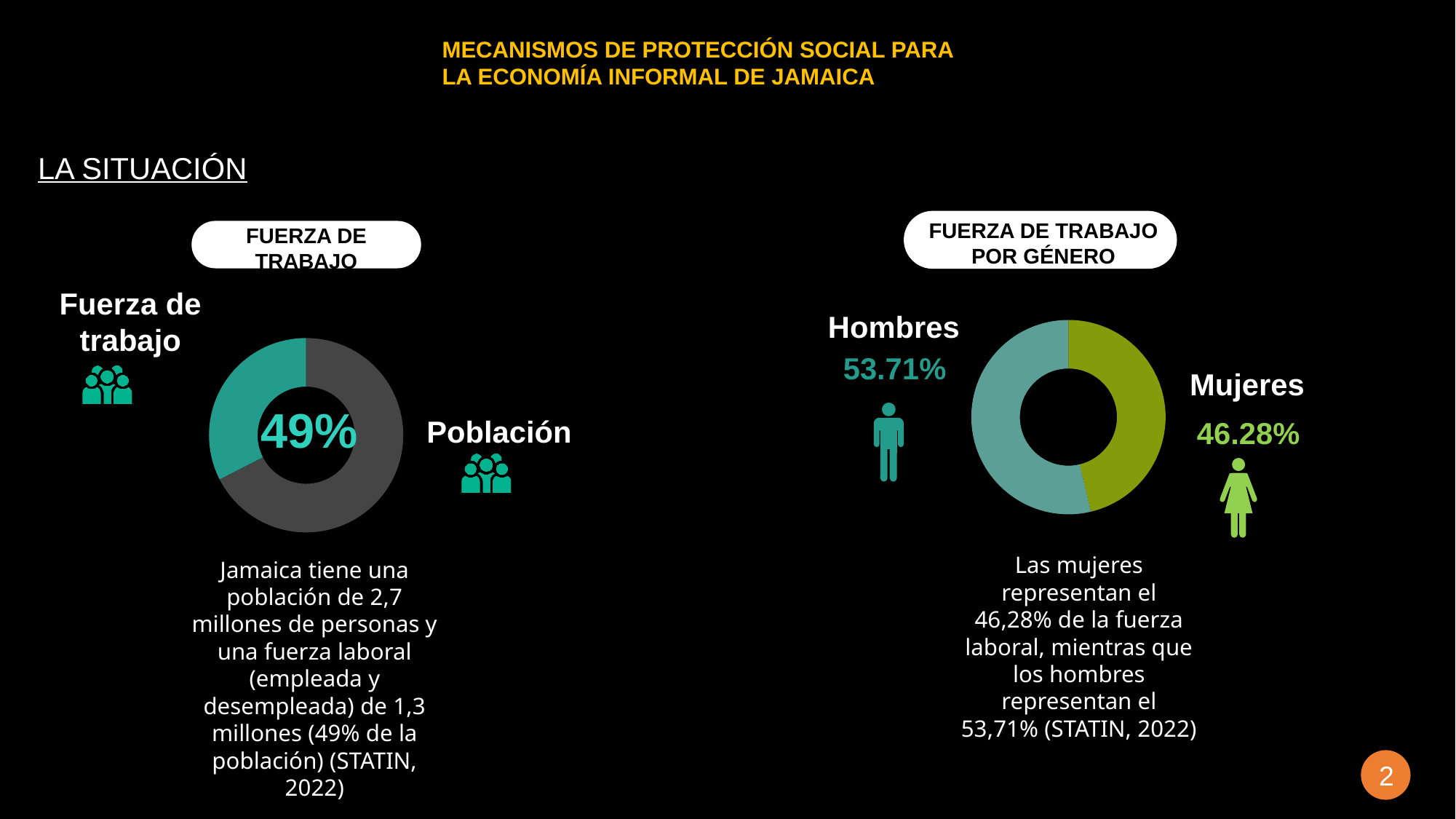
In the 'FUERZA DE TRABAJO' chart on the left, what are the two labelled categories? Fuerza de trabajo and Población In the 'FUERZA DE TRABAJO POR GÉNERO' chart, what percentage is shown for Hombres? 53.71% In the 'FUERZA DE TRABAJO POR GÉNERO' chart, which category has the smallest share? Mujeres How many categories are shown in the 'FUERZA DE TRABAJO' chart on the left? 2 In the 'FUERZA DE TRABAJO POR GÉNERO' chart, what percentage is shown for Mujeres? 46.28% In the 'FUERZA DE TRABAJO' chart on the left, what percentage is printed in the centre of the donut? 49% What kind of chart is the 'FUERZA DE TRABAJO POR GÉNERO' chart? Donut (pie) chart How many charts are on the slide? 2 What kind of chart is the 'FUERZA DE TRABAJO' chart on the left? Donut (pie) chart In the 'FUERZA DE TRABAJO POR GÉNERO' chart, what is the difference in percentage points between Hombres and Mujeres? 7.43 How many categories are shown in the 'FUERZA DE TRABAJO POR GÉNERO' chart? 2 In the 'FUERZA DE TRABAJO POR GÉNERO' chart, which group has the larger share, Hombres or Mujeres? Hombres